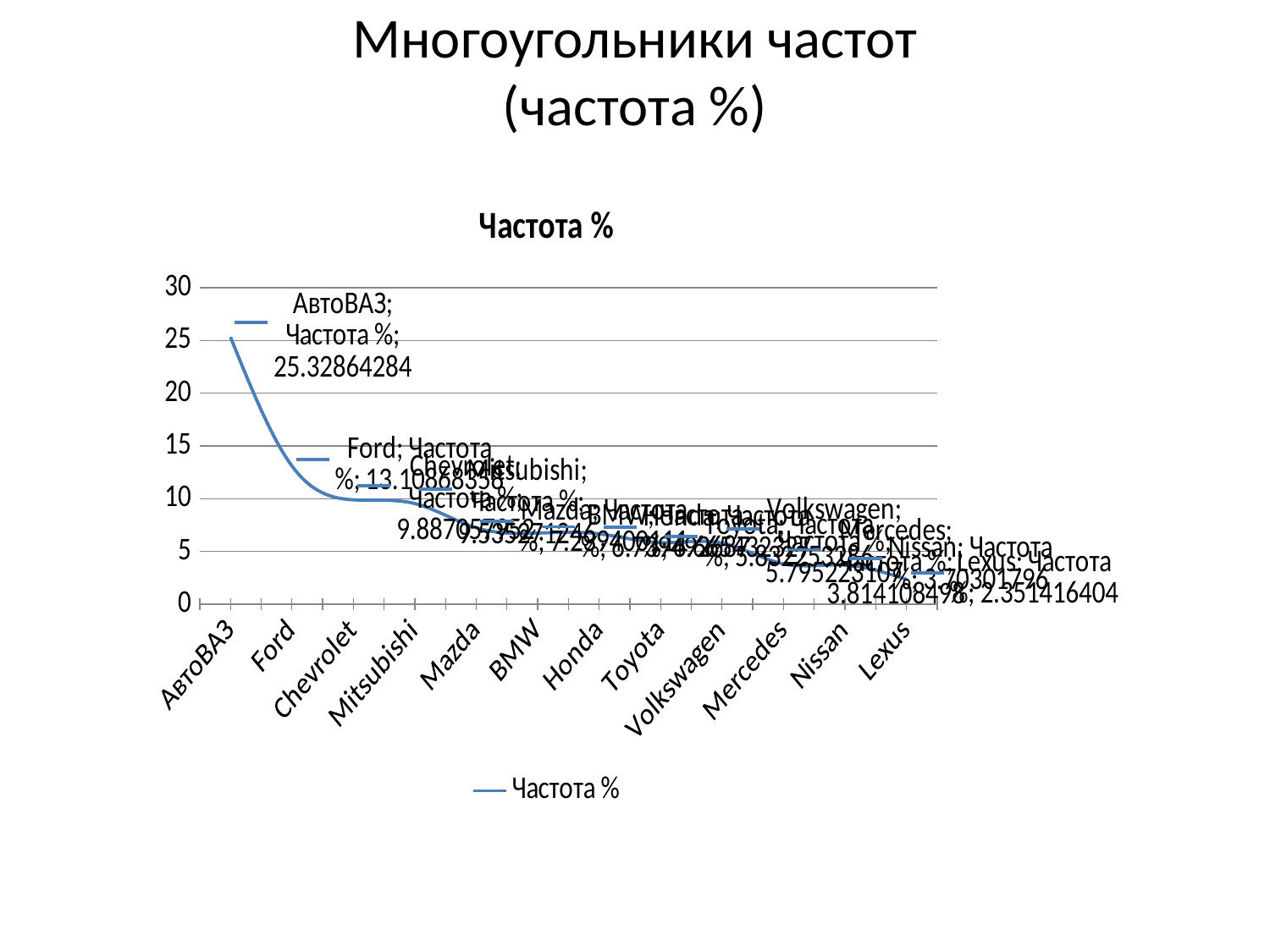
What is the difference between the values for АвтоВАЗ and Ford? 12.21995928 What is the value for Ford in the Частота % chart? 13.10868356 What is the value for Lexus in the Частота % chart? 2.351416404 What type of chart is shown on the slide? line chart Is the value for Mazda greater or less than 10? less Which category has the lowest value in the chart? Lexus Which has a larger value, Ford or Lexus? Ford How many categories are shown on the x axis of the chart? 12 What is the value for АвтоВАЗ in the Частота % chart? 25.32864284 Do the values rise or fall along the x axis from АвтоВАЗ to Lexus? fall What is the value for Nissan in the Частота % chart? 3.70301796 Which category has the highest value in the chart? АвтоВАЗ